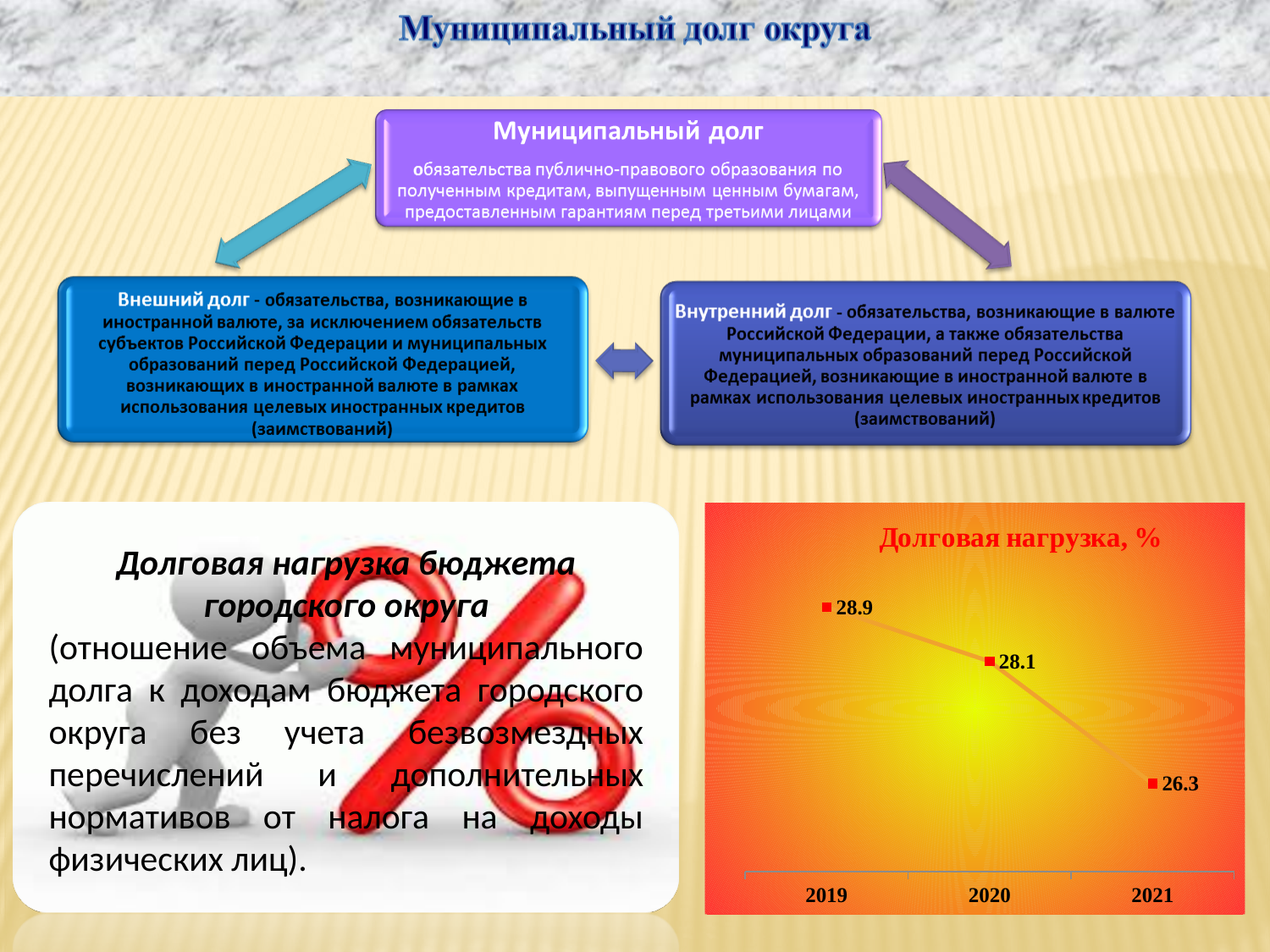
Which year has the lowest debt burden value on the chart? 2021 What kind of chart is used to show the debt burden? line chart Which year has the highest debt burden value on the chart? 2019 Do the debt burden values rise or fall from 2019 to 2021? fall What is the difference between the debt burden values for 2020 and 2021? 1.8 What is the title of the chart on the slide? Долговая нагрузка, % What is the value of the debt burden (Долговая нагрузка) for 2020? 28.1 What is the value of the debt burden (Долговая нагрузка) for 2019? 28.9 How many years (data points) are shown on the debt burden chart? 3 What is the difference between the debt burden values for 2019 and 2021? 2.6 What is the value of the debt burden (Долговая нагрузка) for 2021? 26.3 Which is larger, the debt burden value for 2019 or for 2020? 2019